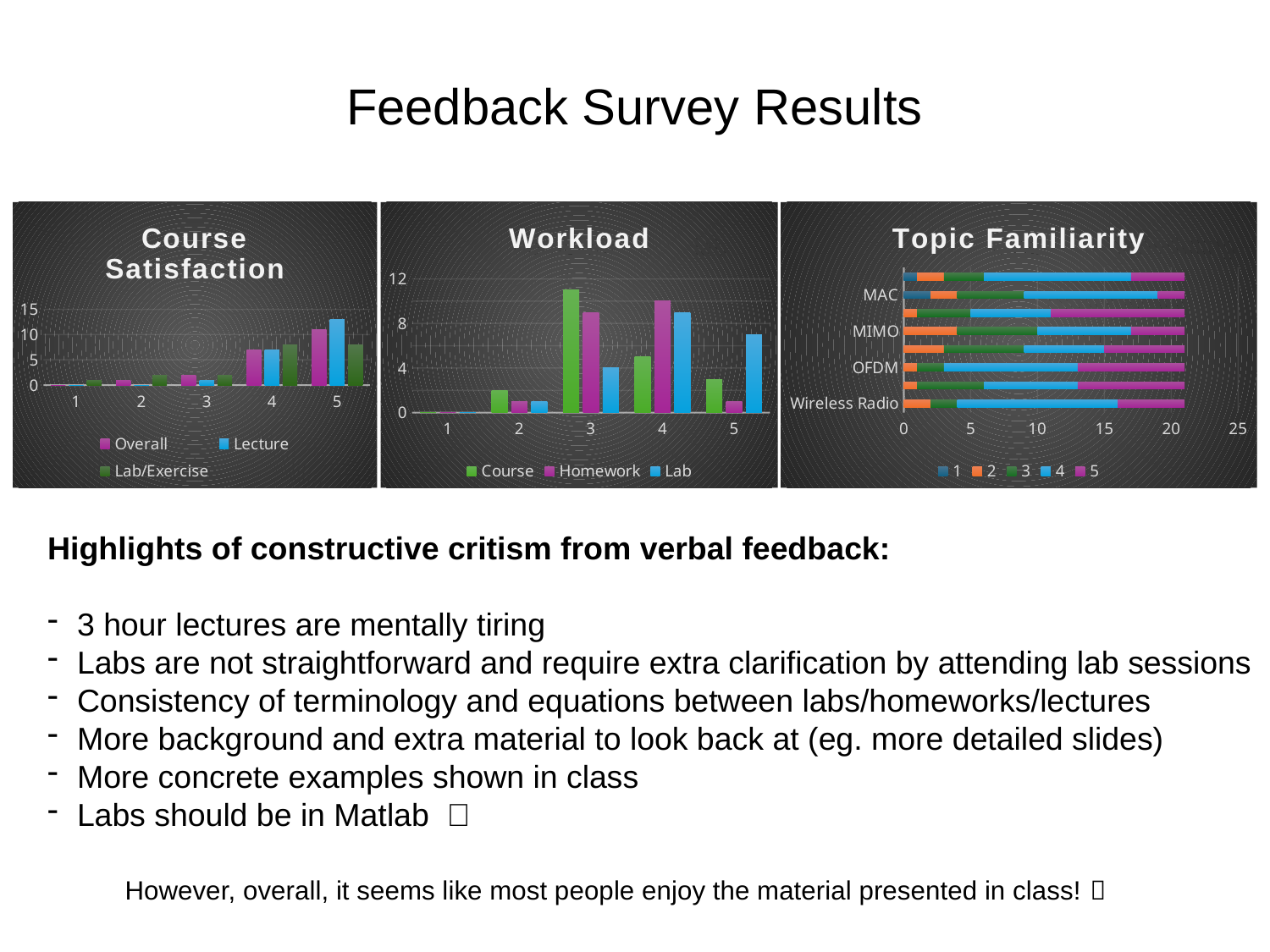
How many categories are shown on the x axis of the Course Satisfaction chart? 5 What are the legend entries of the Course Satisfaction chart? Overall, Lecture, Lab/Exercise How many series does the legend of the Topic Familiarity chart list? 5 In the Workload chart, which series has the highest bar at category 3? Course What kind of chart is the Course Satisfaction chart? Bar chart In the Course Satisfaction chart, is the Lecture value at category 5 greater or less than 10? greater In the Workload chart, is the Course value at category 3 greater or less than 8? greater In the Workload chart, at category 4, which is larger: Homework or Course? Homework In the Workload chart, is the Lab value at category 5 greater or less than 4? greater In the Workload chart, which category has the highest Course bar? 3 What kind of chart is the Topic Familiarity chart? Stacked bar chart How many series does the legend of the Workload chart list? 3